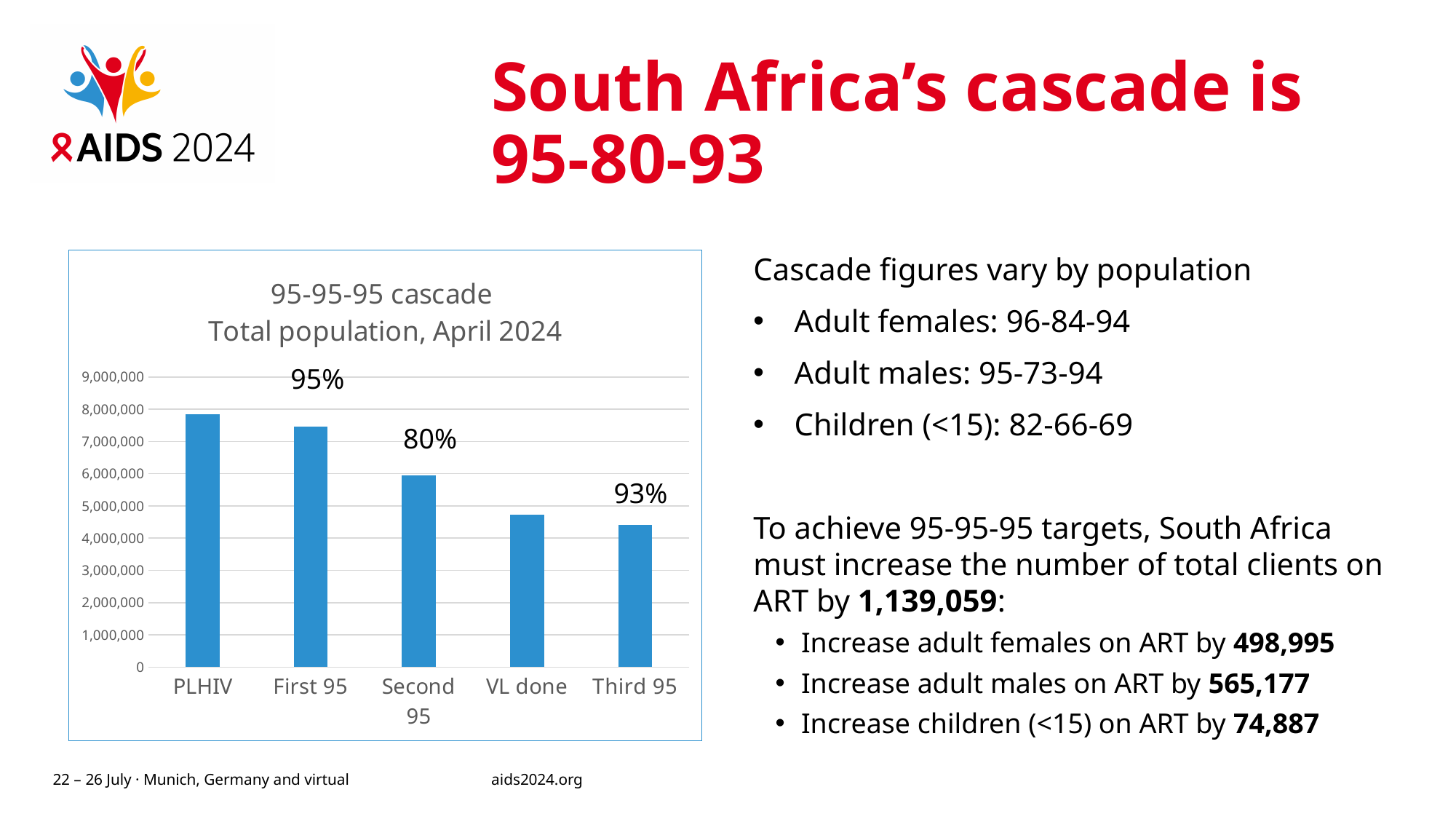
Do the bar values rise or fall from left to right along the x axis? fall Is the value for VL done greater or less than 5,000,000? less What is the title of the chart? 95-95-95 cascade Total population, April 2024 What kind of chart is shown on the slide? bar chart Is the value for Third 95 greater or less than 4,000,000? greater What percentage label is printed above the Second 95 bar? 80% How many categories are plotted on the x axis of the chart? 5 Which category has the shortest bar in the chart? Third 95 Is the value for Second 95 greater or less than 5,000,000? greater Which category has the tallest bar in the chart? PLHIV Which bar is taller, PLHIV or Second 95? PLHIV